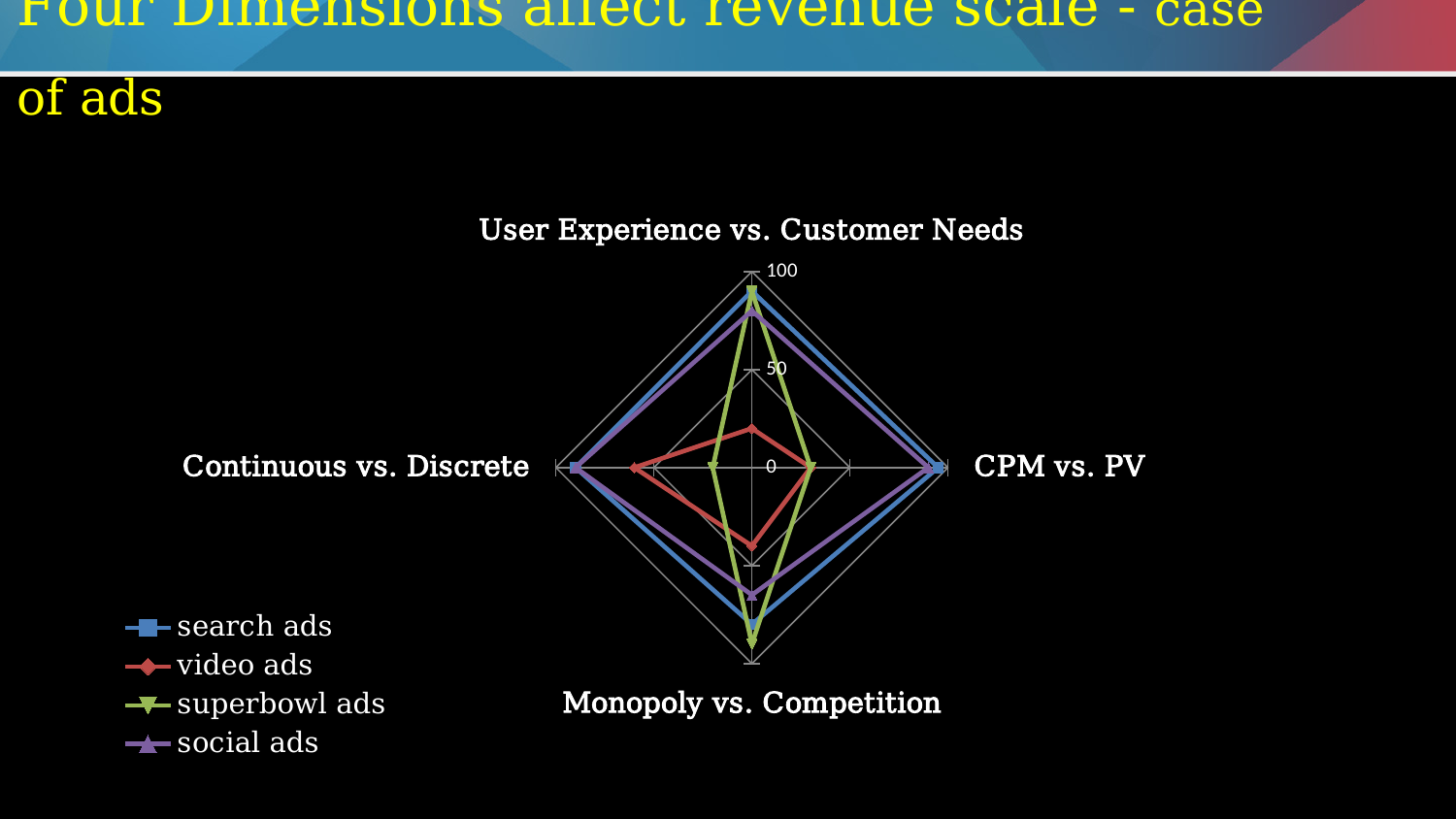
Is the value for video ads on the User Experience vs. Customer Needs axis greater or less than 50? less Which series has the lowest value on the Continuous vs. Discrete axis? superbowl ads What colour is the line for superbowl ads in the legend? green What kind of chart is shown on the slide? radar chart Is the value for superbowl ads on the Monopoly vs. Competition axis greater or less than 50? greater On the Continuous vs. Discrete axis, which is larger: video ads or superbowl ads? video ads Which series has the lowest value on the User Experience vs. Customer Needs axis? video ads How many series does the legend list? 4 Which series has the lowest value on the Monopoly vs. Competition axis? video ads How many axes (categories) does the radar chart have? 4 Is the value for superbowl ads on the Continuous vs. Discrete axis greater or less than 50? less